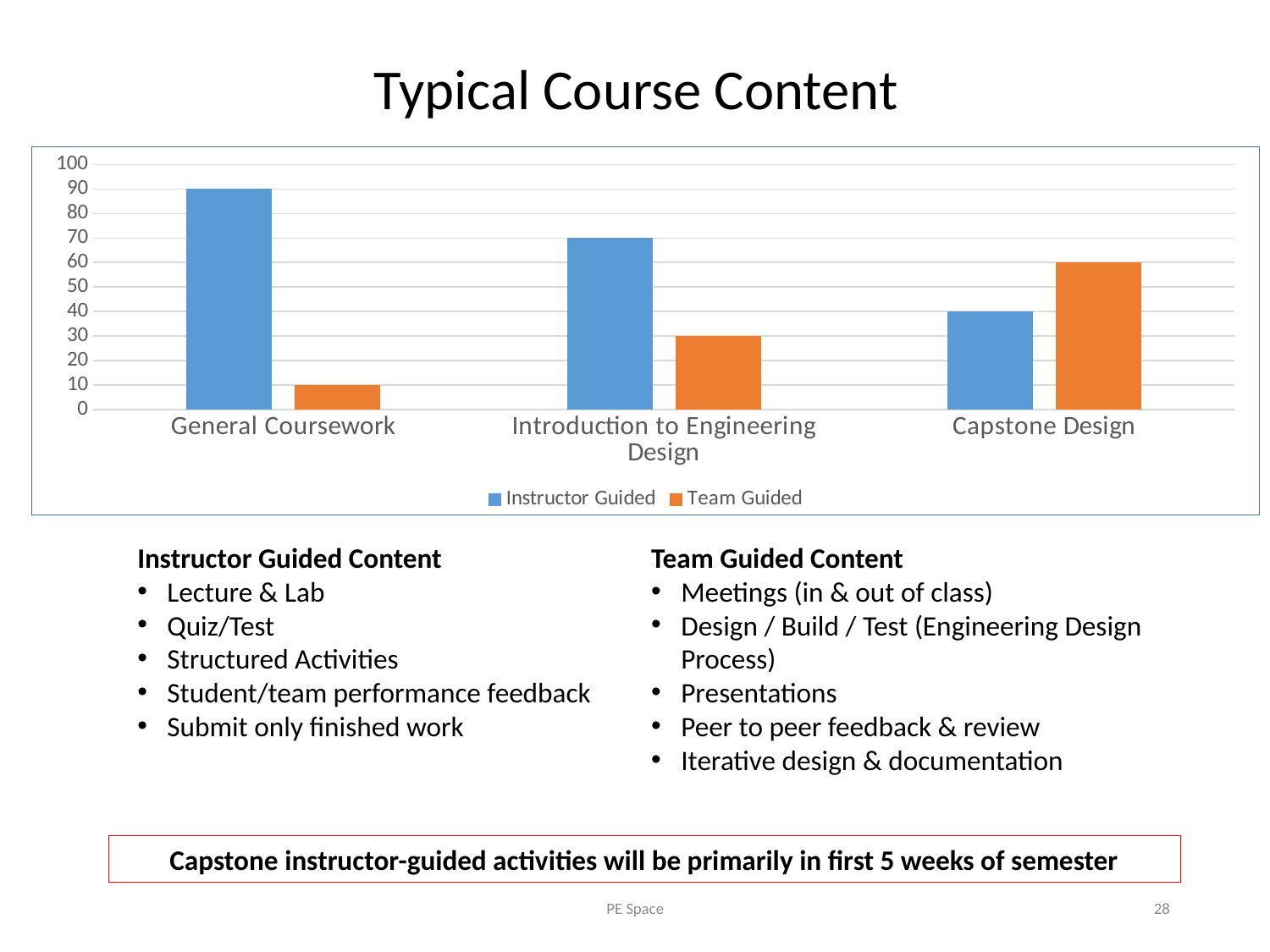
What is the Instructor Guided value for General Coursework? 90 What is the Team Guided value for Capstone Design? 60 Which category has the lowest Team Guided value? General Coursework For Capstone Design, which is larger: Instructor Guided or Team Guided? Team Guided What is the difference between the Instructor Guided and Team Guided values for Introduction to Engineering Design? 40 What is the Team Guided value for Introduction to Engineering Design? 30 How many series does the chart legend list? 2 What colour are the Team Guided bars in the chart? orange What type of chart is shown on the slide? bar chart Do the Instructor Guided values rise or fall from General Coursework to Capstone Design? fall How many categories are shown on the x axis of the chart? 3 Which category has the highest Instructor Guided value? General Coursework